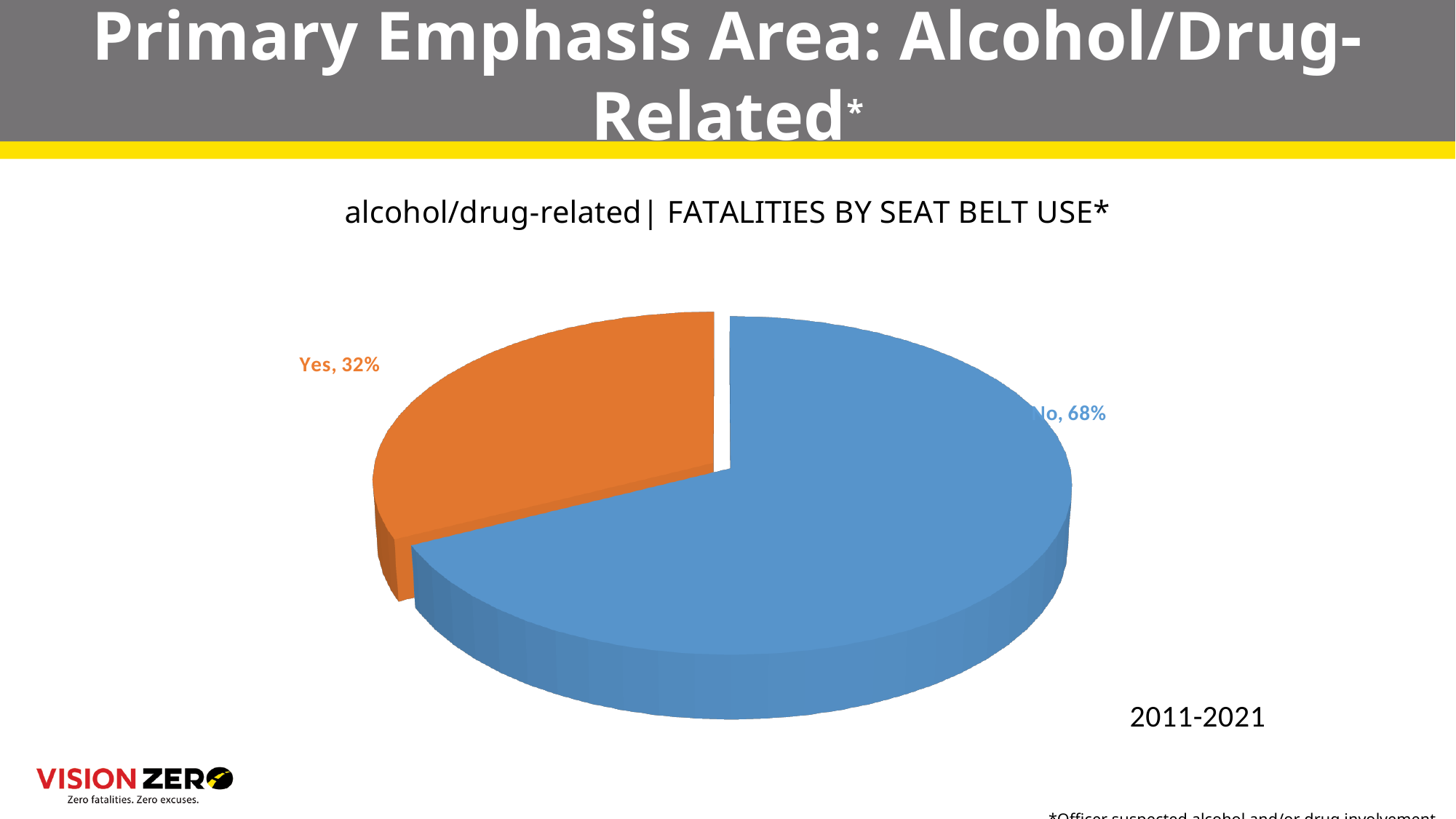
Which is larger, the "Yes" slice or the "No" slice? No What share of alcohol/drug-related fatalities is labelled "No" for seat belt use? 68% Which slice of the pie is the smallest? Yes What kind of chart is shown on the slide? Pie chart What is the title of the chart? alcohol/drug-related | FATALITIES BY SEAT BELT USE* What colour is the "No" slice of the pie? Blue Which slice of the pie is the largest? No What share of alcohol/drug-related fatalities is labelled "Yes" for seat belt use? 32% What share of the pie does the "Yes" slice represent? 32% What time period does the chart cover, as shown on the slide? 2011-2021 What is the difference in percentage points between the "No" and "Yes" slices? 36 How many slices does the pie chart have? 2